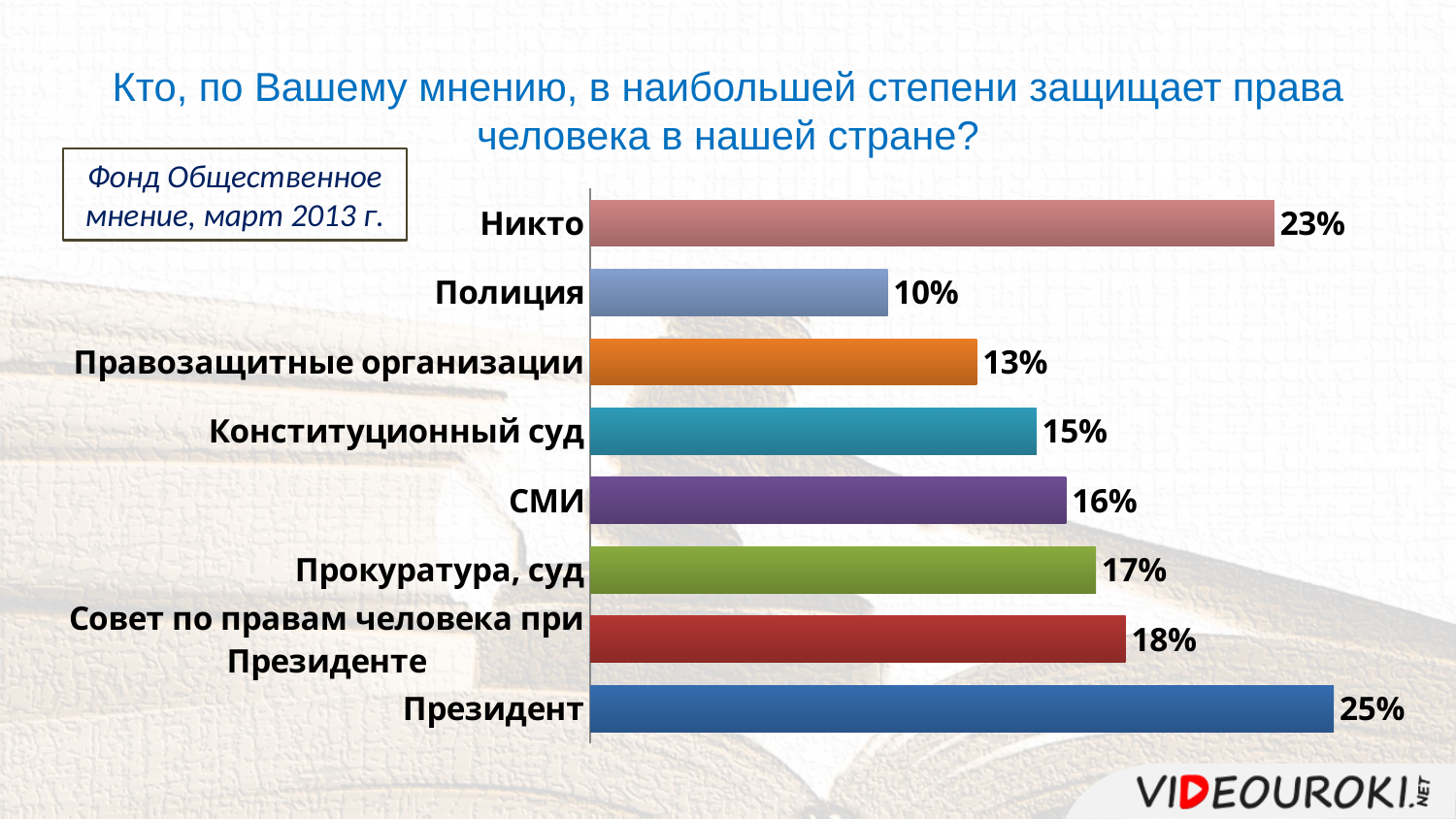
What is the value for Совет по правам человека при Президенте? 18% What kind of chart is shown on the slide? Bar chart What source and date are given for the data in the box at the top left? Фонд Общественное мнение, март 2013 г. What is the value for Полиция? 10% What is the value for Конституционный суд? 15% What is the value for Президент? 25% How many categories are shown in the chart? 8 Which is larger, the value for СМИ or the value for Правозащитные организации? СМИ What is the difference between the values for Президент and Никто? 2% Which category has the lowest value? Полиция Which category has the highest value? Президент What is the difference between the values for Прокуратура, суд and Полиция? 7%